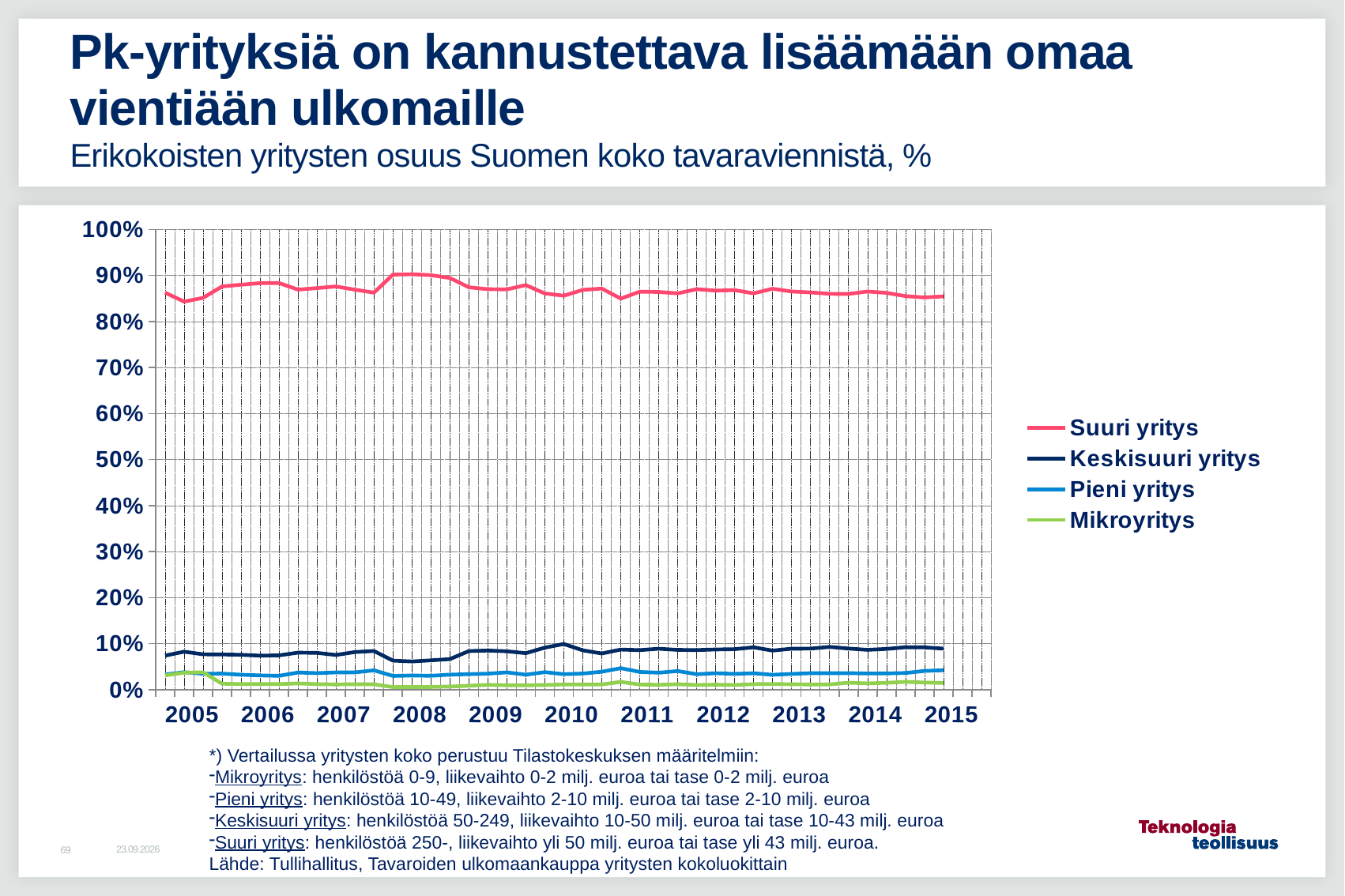
How many series does the legend list? 4 What kind of chart is shown on the slide? line chart Which series has the highest share of exports throughout the period? Suuri yritys Which series has the lowest share of exports in 2015? Mikroyritys Is the value for Mikroyritys in 2015 greater or less than 10%? less What are the four legend entries of the chart? Suuri yritys, Keskisuuri yritys, Pieni yritys, Mikroyritys In 2012, which is larger: Keskisuuri yritys or Pieni yritys? Keskisuuri yritys Does the Mikroyritys line rise or fall from 2005 to 2008? fall Is the value for Keskisuuri yritys in 2010 greater or less than 20%? less Is the value for Suuri yritys in 2008 greater or less than 80%? greater How many years are labelled on the x axis? 11 In 2005, which is larger: Suuri yritys or Keskisuuri yritys? Suuri yritys